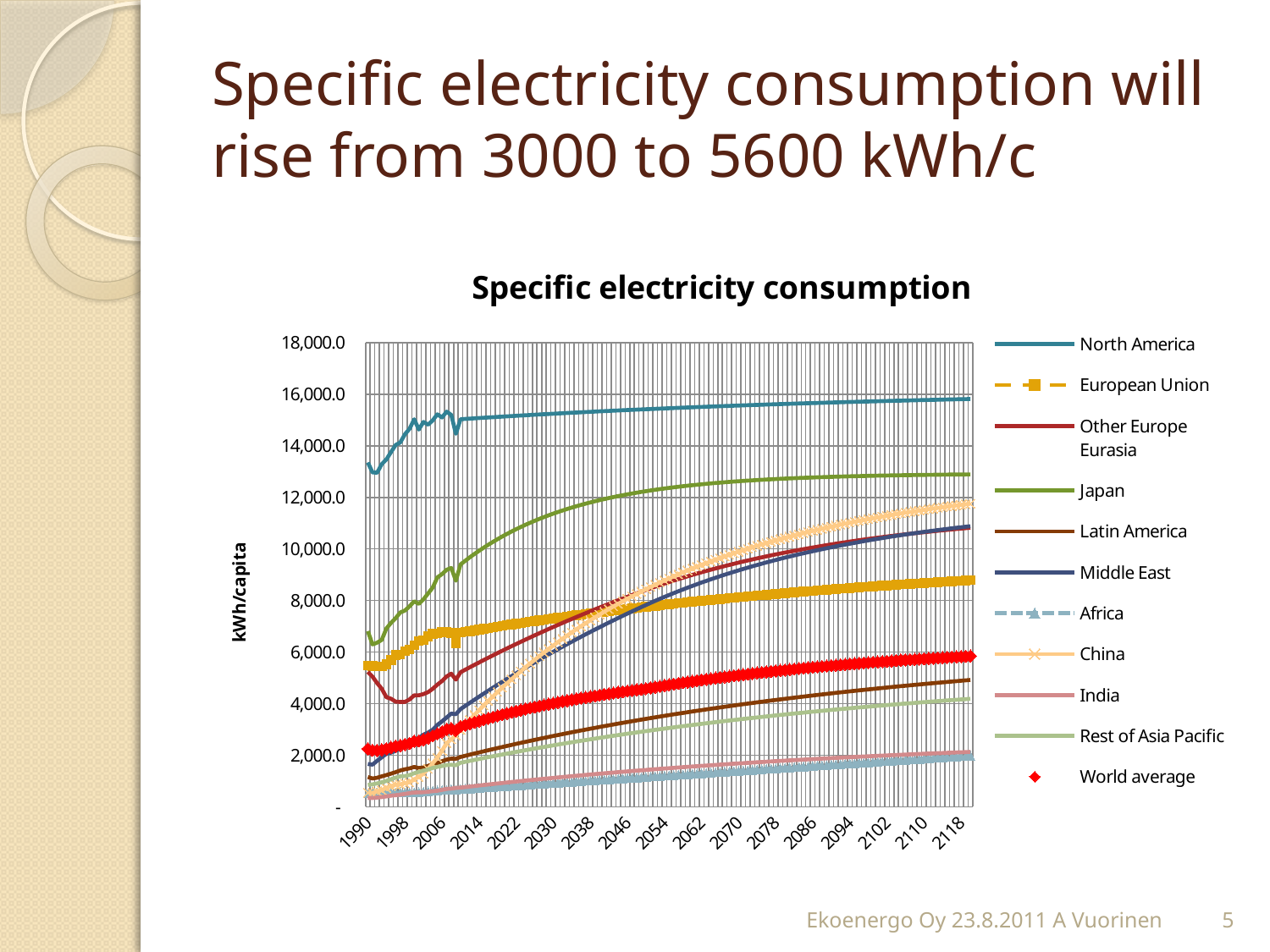
What kind of chart is shown on the slide? line chart Is the value for World average in 1990 greater or less than 4,000? less Is the value for Latin America in 2118 greater or less than 4,000? greater What is the label on the vertical axis of the chart? kWh/capita Is the value for North America in 2118 greater or less than 14,000? greater What is the title of the chart? Specific electricity consumption Which series has the highest values across the whole period in the Specific electricity consumption chart? North America Does the China series rise or fall from 1990 to 2118? rise How many series does the legend of the Specific electricity consumption chart list? 11 Which is higher in 2118, Japan or Middle East? Japan